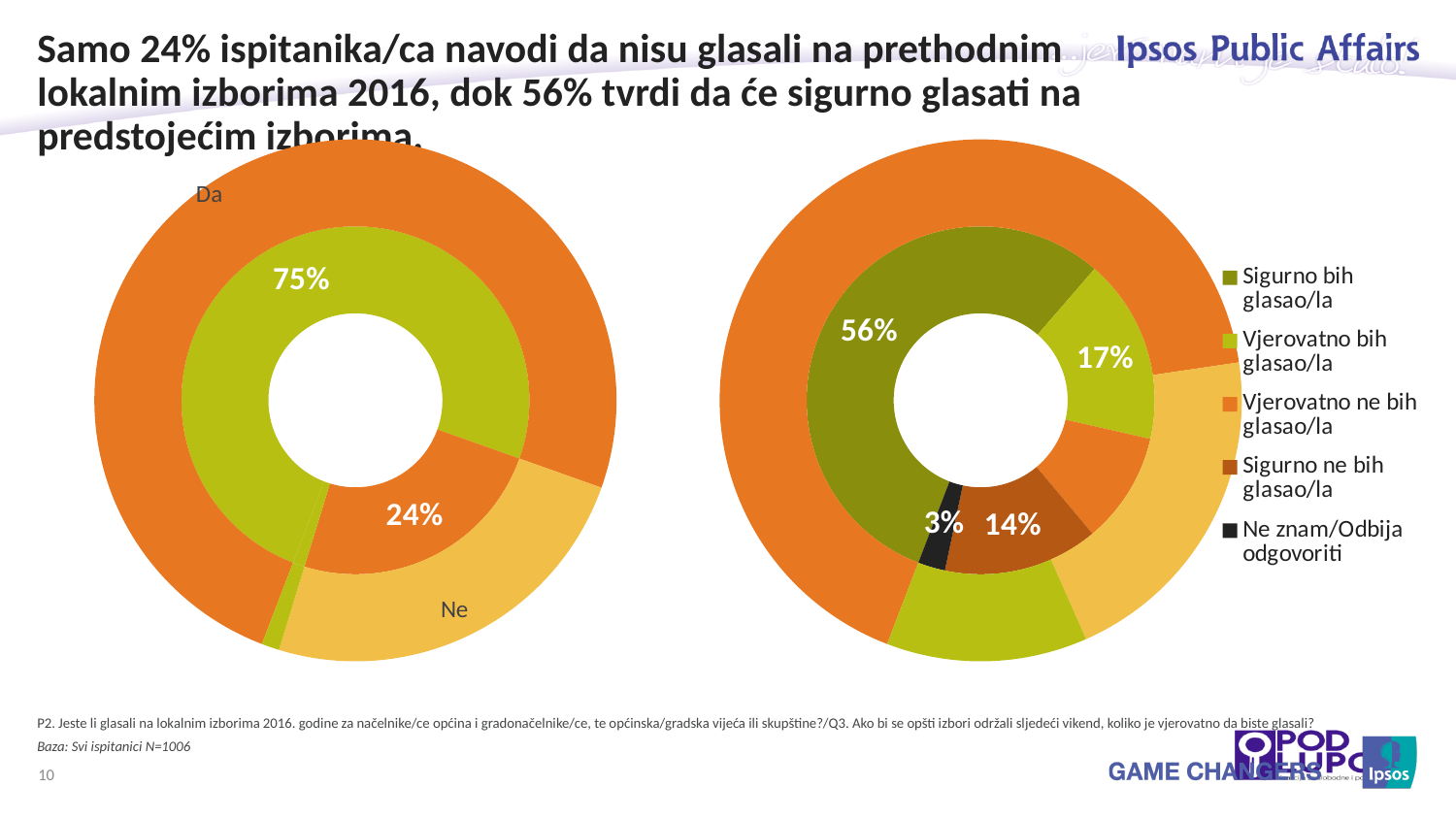
In the left chart, which answer has the larger share, "Da" or "Ne"? Da In the left chart, what is the difference in percentage points between "Da" and "Ne"? 51 percentage points How many categories are shown in the left chart? 3 In the right chart, which category has the smallest share? Ne znam/Odbija odgovoriti In the left chart, what percentage of respondents answered "Ne"? 24% In the right chart, what percentage of respondents chose "Sigurno bih glasao/la"? 56% How many entries does the legend of the right chart list? 5 In the left chart, what percentage of respondents answered "Da"? 75% In the right chart, which is larger, "Sigurno bih glasao/la" or "Vjerovatno bih glasao/la"? Sigurno bih glasao/la What kind of chart is the left chart? Doughnut (pie) chart In the right chart, what percentage of respondents chose "Vjerovatno bih glasao/la"? 17% In the right chart, which category has the largest share? Sigurno bih glasao/la